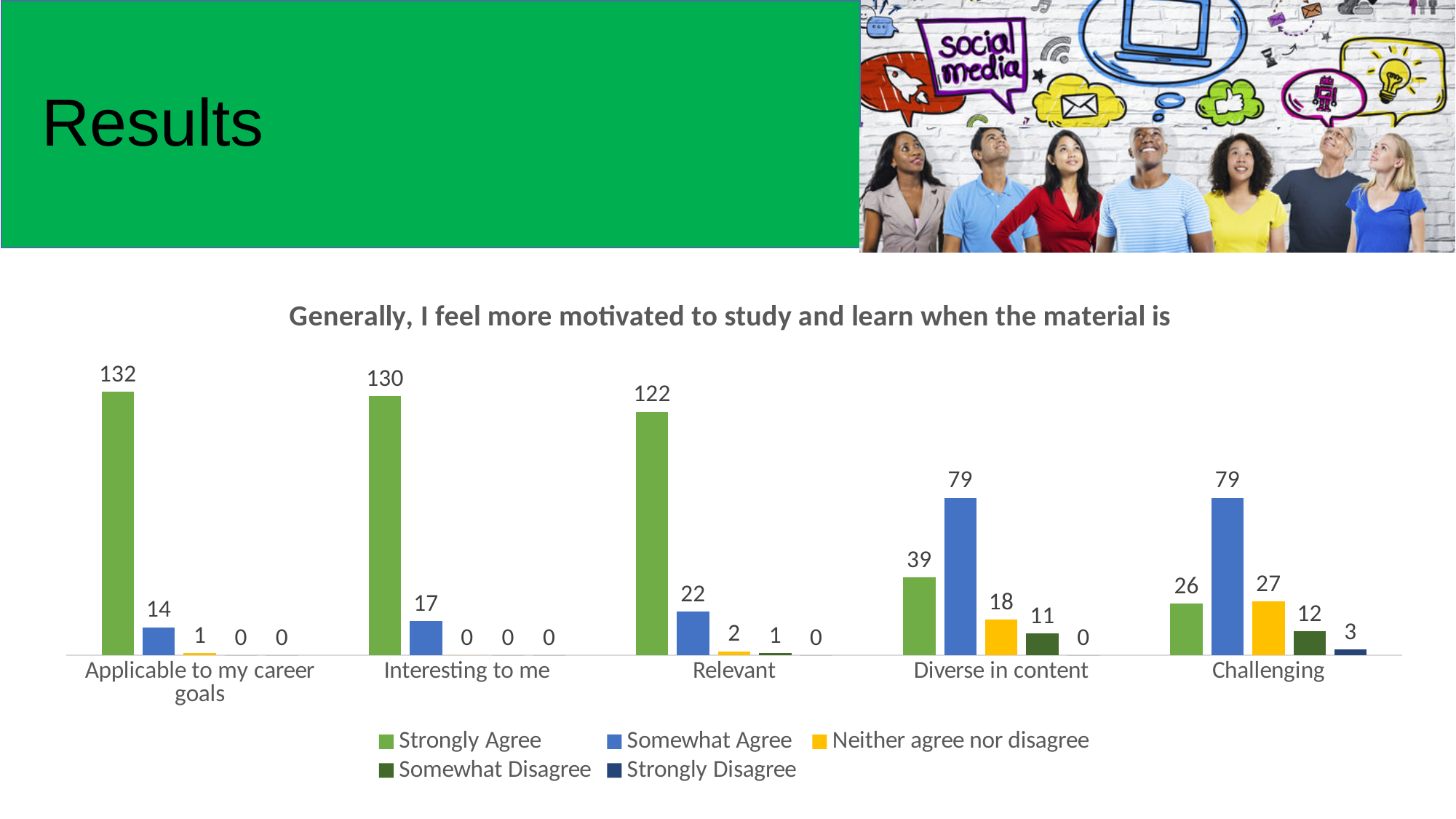
How many categories are shown on the x axis? 5 Which category has the lowest Strongly Agree value? Challenging What is the Strongly Disagree value for 'Challenging'? 3 Which is larger for 'Challenging': Somewhat Agree or Strongly Agree? Somewhat Agree What is the Strongly Agree value for 'Applicable to my career goals'? 132 What is the title of the chart? Generally, I feel more motivated to study and learn when the material is What is the difference between the Strongly Agree values for 'Interesting to me' and 'Relevant'? 8 Which category has the highest Strongly Agree value? Applicable to my career goals What kind of chart is shown on the slide? Bar chart How many series does the legend list? 5 What is the Neither agree nor disagree value for 'Challenging'? 27 What is the Somewhat Agree value for 'Diverse in content'? 79